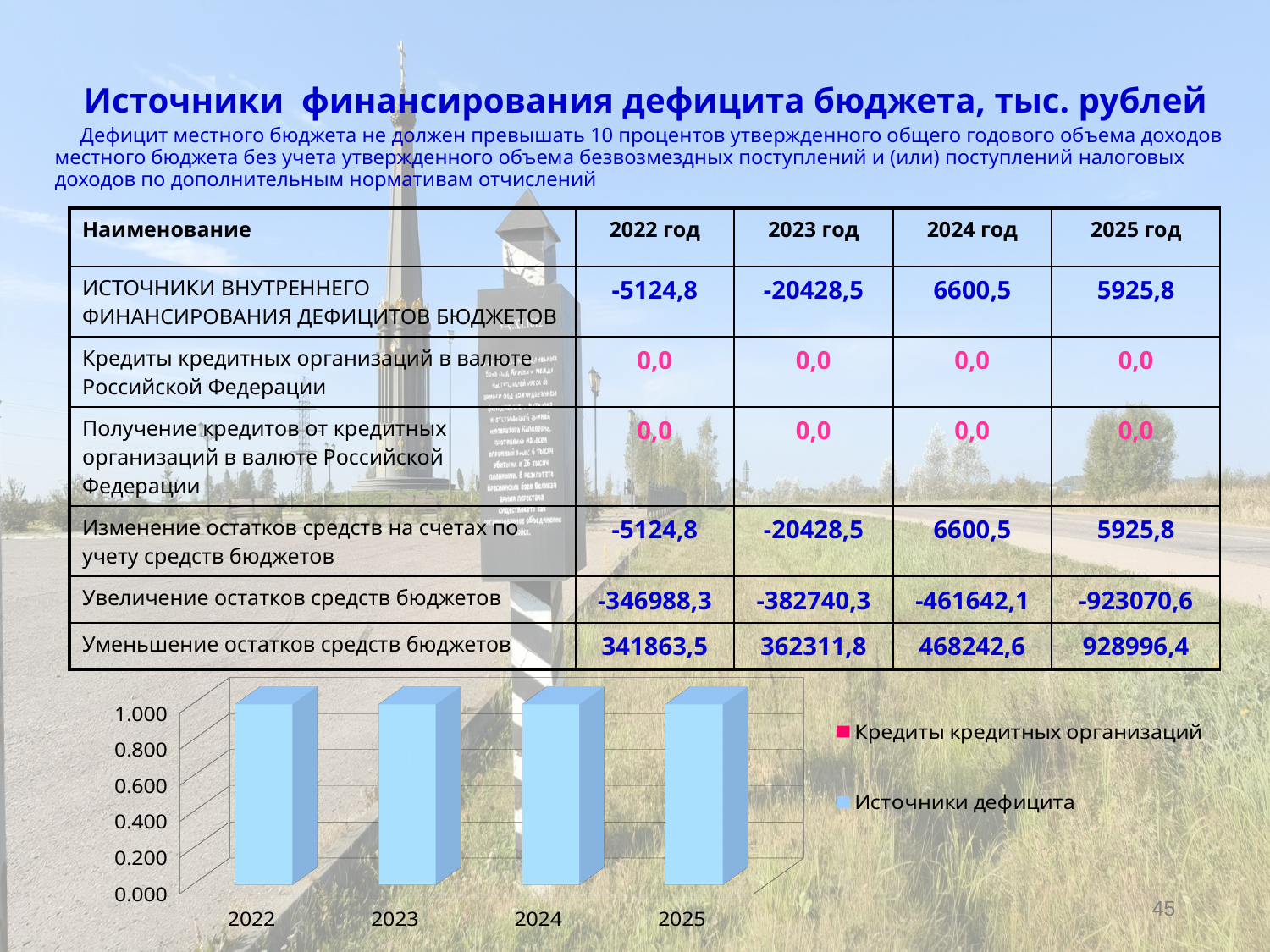
What kind of chart is shown at the bottom of the slide? bar chart What is the first entry in the legend of the bar chart? Кредиты кредитных организаций Which years are shown along the x axis of the bar chart? 2022, 2023, 2024, 2025 How many years are shown on the x axis of the bar chart? 4 How many series does the legend of the bar chart list? 2 What is the highest value shown on the y axis of the bar chart? 1.000 Is the bar for 2025 in the bar chart greater or less than 0.600? greater Is the bar for 2023 in the bar chart greater or less than 0.400? greater Is the bar for 2024 in the bar chart greater or less than 0.200? greater